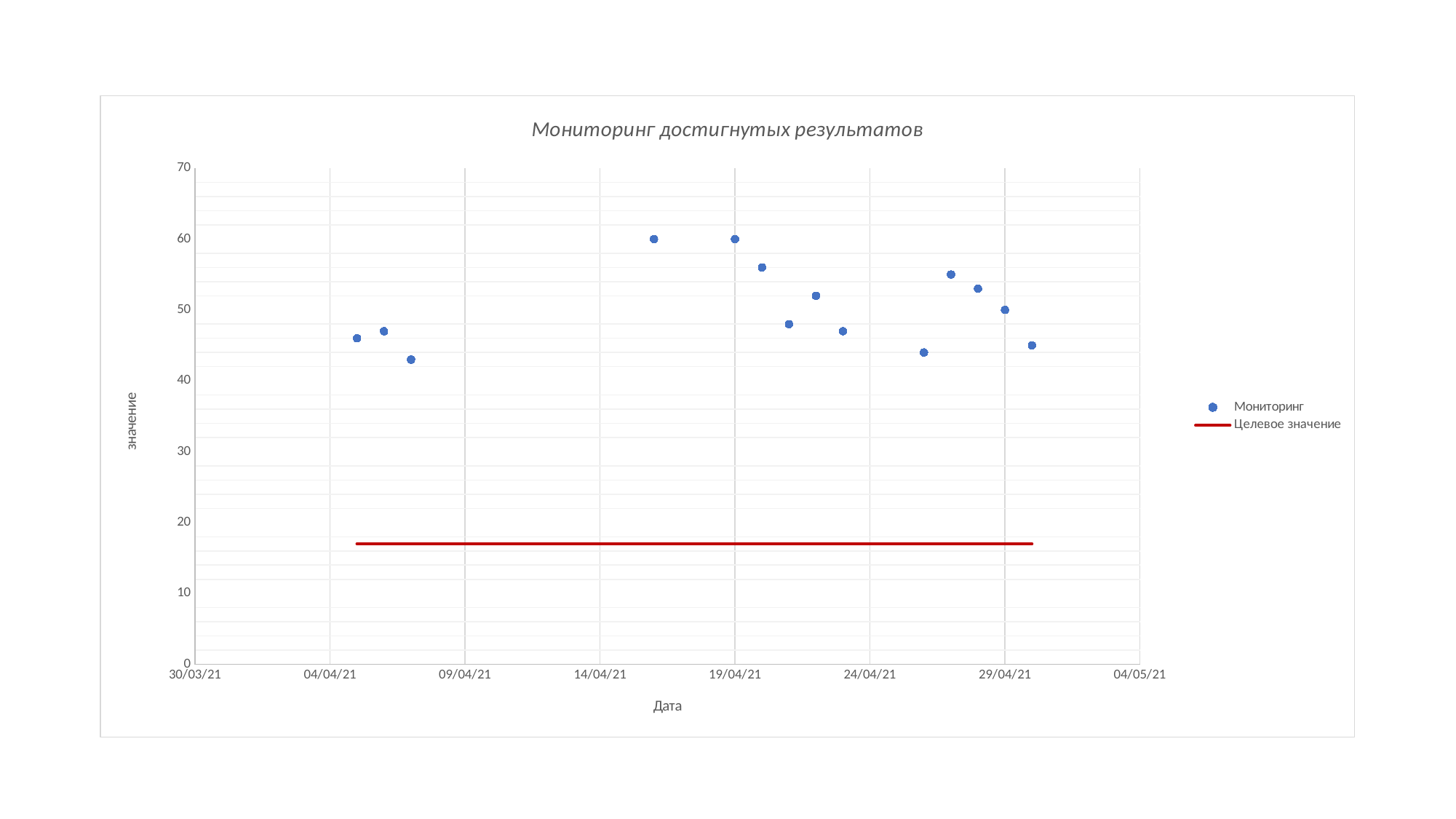
Is the highest Мониторинг point greater or less than 50? greater Is the Мониторинг value at 19/04/21 greater or less than 50? greater Are all the Мониторинг points greater or less than 40? greater What kind of chart is shown on the slide? scatter chart Is the Мониторинг value at 19/04/21 larger than the target line value? Yes How many series does the legend list? 2 What is the title of the chart? Мониторинг достигнутых результатов How many Мониторинг data points are plotted on the chart? 14 What are the two legend entries of the chart? Мониторинг, Целевое значение